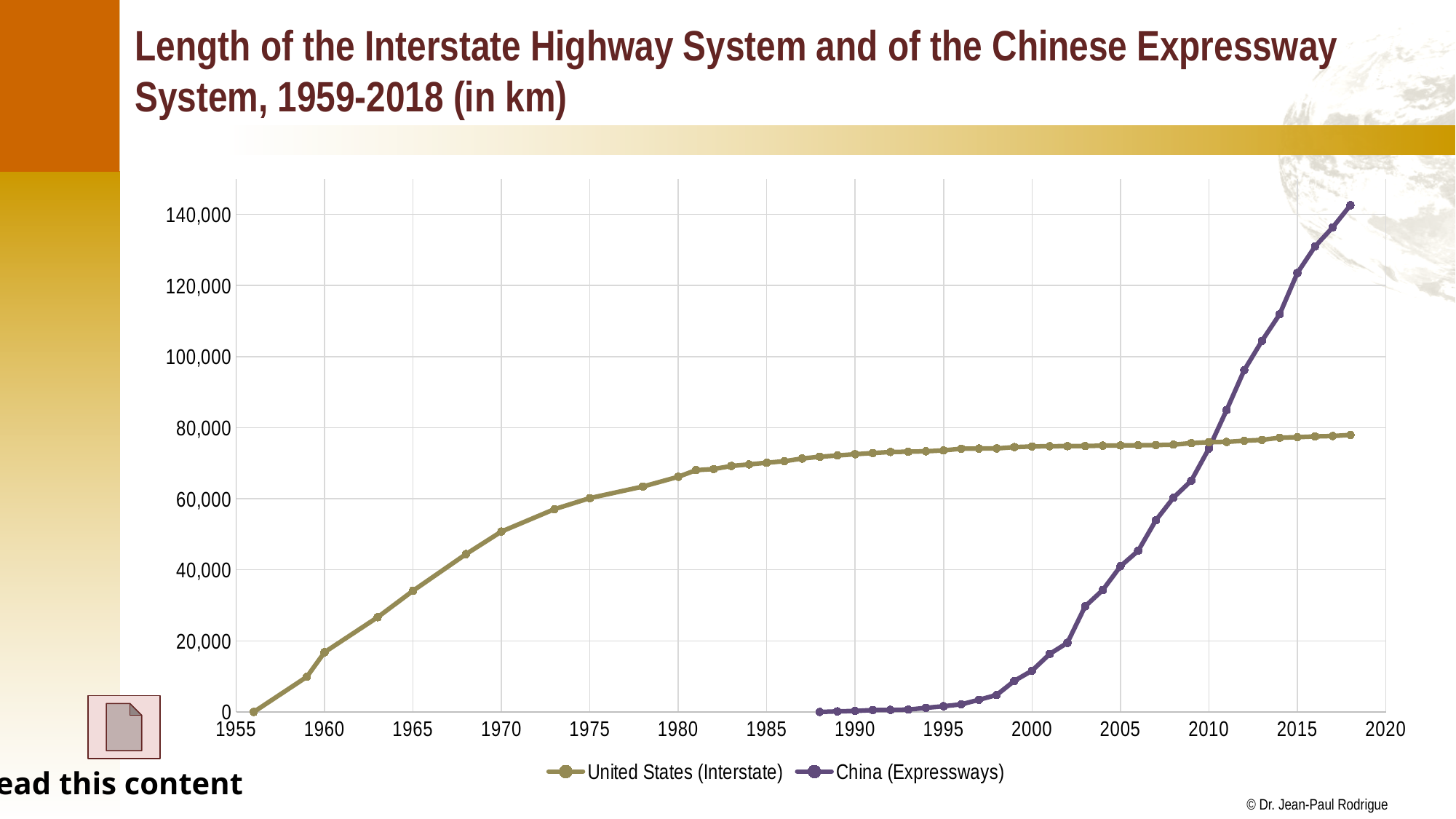
Is the value for China (Expressways) in 2000 greater or less than 20,000? less What unit of length does the chart title say the values are in? km Is the value for China (Expressways) in 2010 greater or less than 60,000? greater Which two series are listed in the legend? United States (Interstate) and China (Expressways) Does the China (Expressways) series rise or fall from 1988 to 2018? rise How many series does the legend list? 2 Is the value for United States (Interstate) in 1970 greater or less than 40,000? greater What kind of chart is shown on the slide? line chart Does the United States (Interstate) series rise or fall from 1956 to 2018? rise In 2018, which series has the larger value, United States (Interstate) or China (Expressways)? China (Expressways) In 2005, which series has the larger value, United States (Interstate) or China (Expressways)? United States (Interstate)